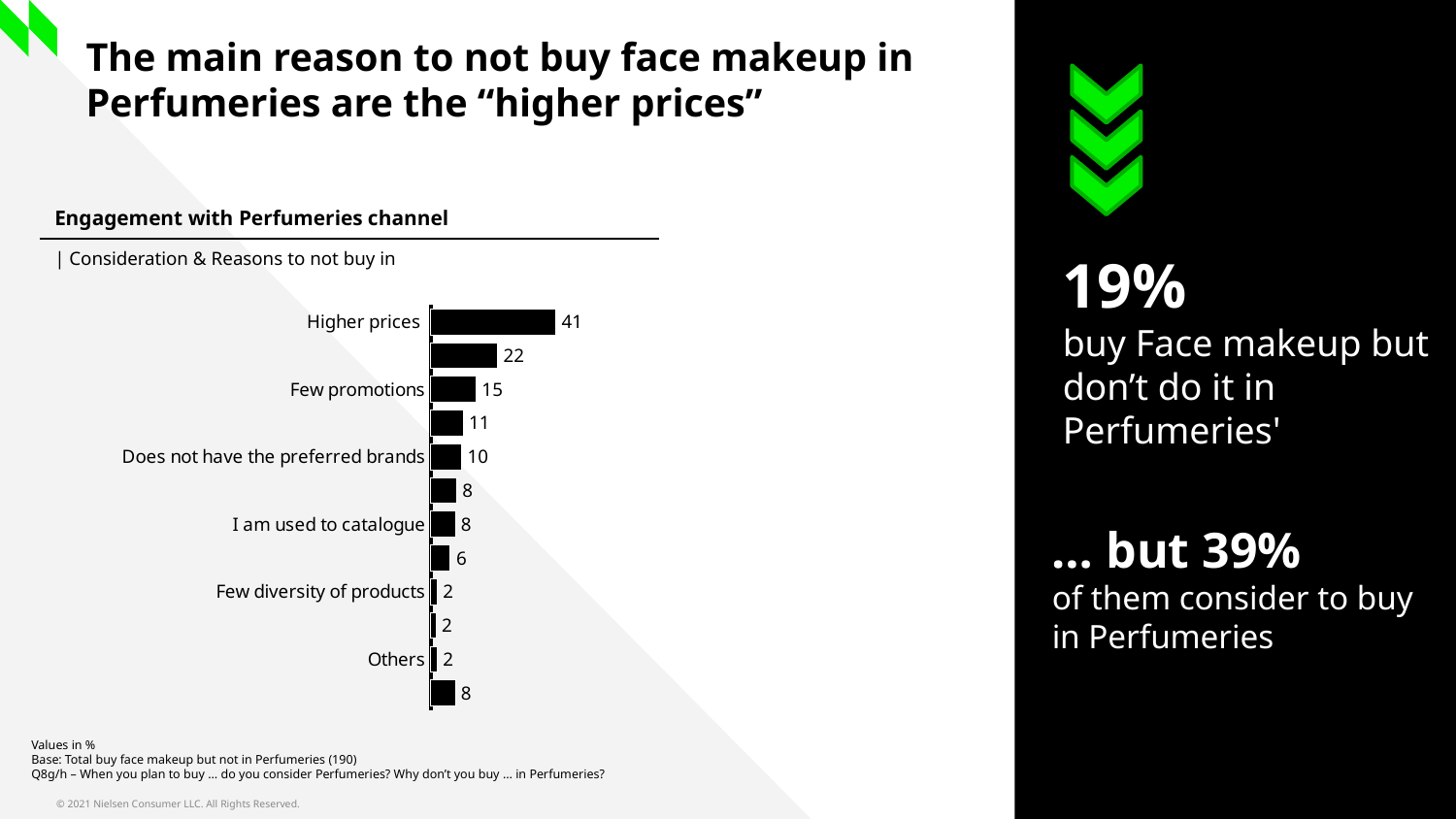
What kind of chart is shown on the slide? Bar chart What is the heading printed above the chart? Engagement with Perfumeries channel What is the value for "Higher prices" in the chart? 41 What is the value for "Few diversity of products" in the chart? 2 Which reason has the highest value in the chart? Higher prices What is the value for "I am used to catalogue" in the chart? 8 What is the value for "Few promotions" in the chart? 15 What is the value for "Others" in the chart? 2 What is the difference between the values for "Does not have the preferred brands" and "I am used to catalogue"? 2 What is the difference between the values for "Higher prices" and "Few promotions"? 26 Which is larger: the value for "Few promotions" or for "Does not have the preferred brands"? Few promotions What is the value for "Does not have the preferred brands" in the chart? 10